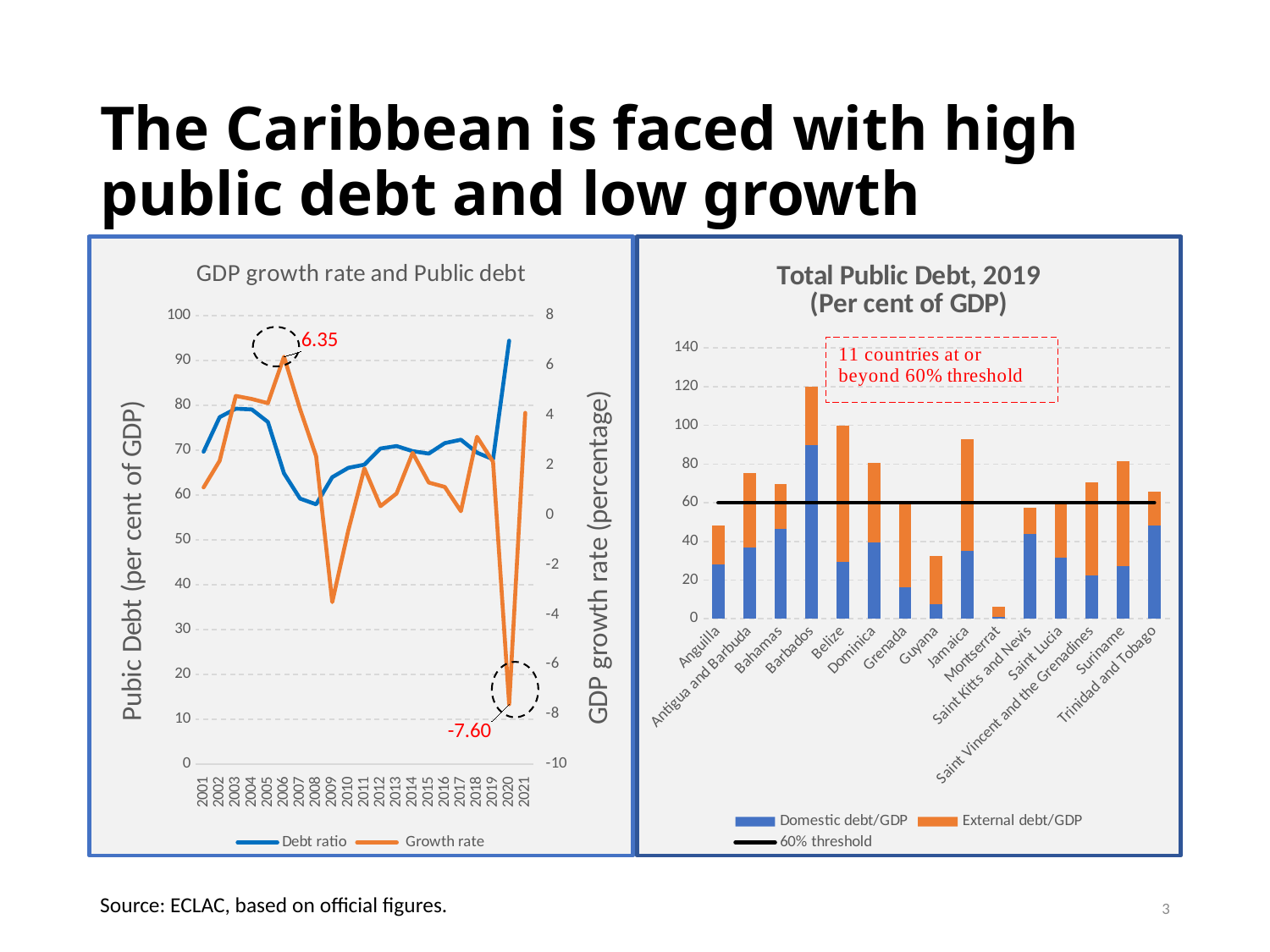
In the left chart 'GDP growth rate and Public debt', in which year does the growth rate reach its labeled low of -7.60? 2020 In the right chart 'Total Public Debt, 2019', what does the annotation in the box say? 11 countries at or beyond 60% threshold In the right chart 'Total Public Debt, 2019', is the total public debt for Guyana greater or less than 40? less What kind of chart is the right chart titled 'Total Public Debt, 2019'? bar chart In the right chart 'Total Public Debt, 2019', how many countries are shown? 15 In the right chart 'Total Public Debt, 2019', which country has the lowest total public debt? Montserrat In the left chart 'GDP growth rate and Public debt', what is the labeled lowest value of the growth rate? -7.60 In the left chart 'GDP growth rate and Public debt', what is the labeled peak value of the growth rate? 6.35 What kind of chart is the left chart titled 'GDP growth rate and Public debt'? line chart In the right chart 'Total Public Debt, 2019', which country has the highest total public debt? Barbados In the left chart 'GDP growth rate and Public debt', how many series does the legend list? 2 In the left chart 'GDP growth rate and Public debt', how many years are shown on the x axis? 21